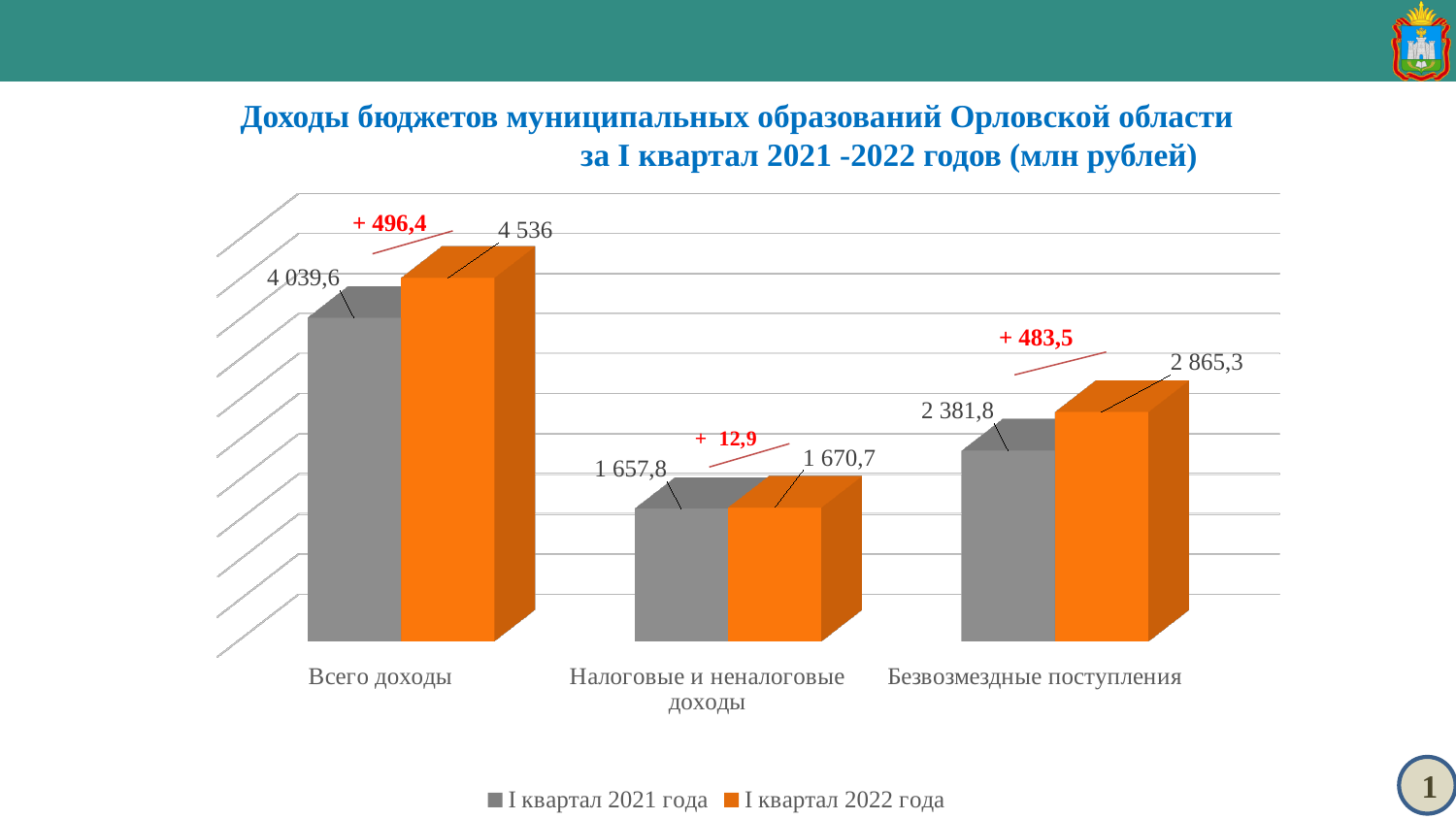
What kind of chart is shown on the slide? Bar chart What is the value for «Всего доходы» in I квартал 2021 года? 4 039,6 What is the value for «Безвозмездные поступления» in I квартал 2022 года? 2 865,3 How many categories are shown on the x axis of the chart? 3 What is the value for «Всего доходы» in I квартал 2022 года? 4 536 How many series does the legend list? 2 Which category has the highest value for I квартал 2021 года? Всего доходы What is the value for «Налоговые и неналоговые доходы» in I квартал 2021 года? 1 657,8 What is the difference between the I квартал 2022 года and I квартал 2021 года values for «Безвозмездные поступления»? 483,5 Which category has the lowest value for I квартал 2022 года? Налоговые и неналоговые доходы Which is larger for «Всего доходы»: the value for I квартал 2021 года or I квартал 2022 года? I квартал 2022 года What is the difference between the I квартал 2022 года and I квартал 2021 года values for «Налоговые и неналоговые доходы»? 12,9